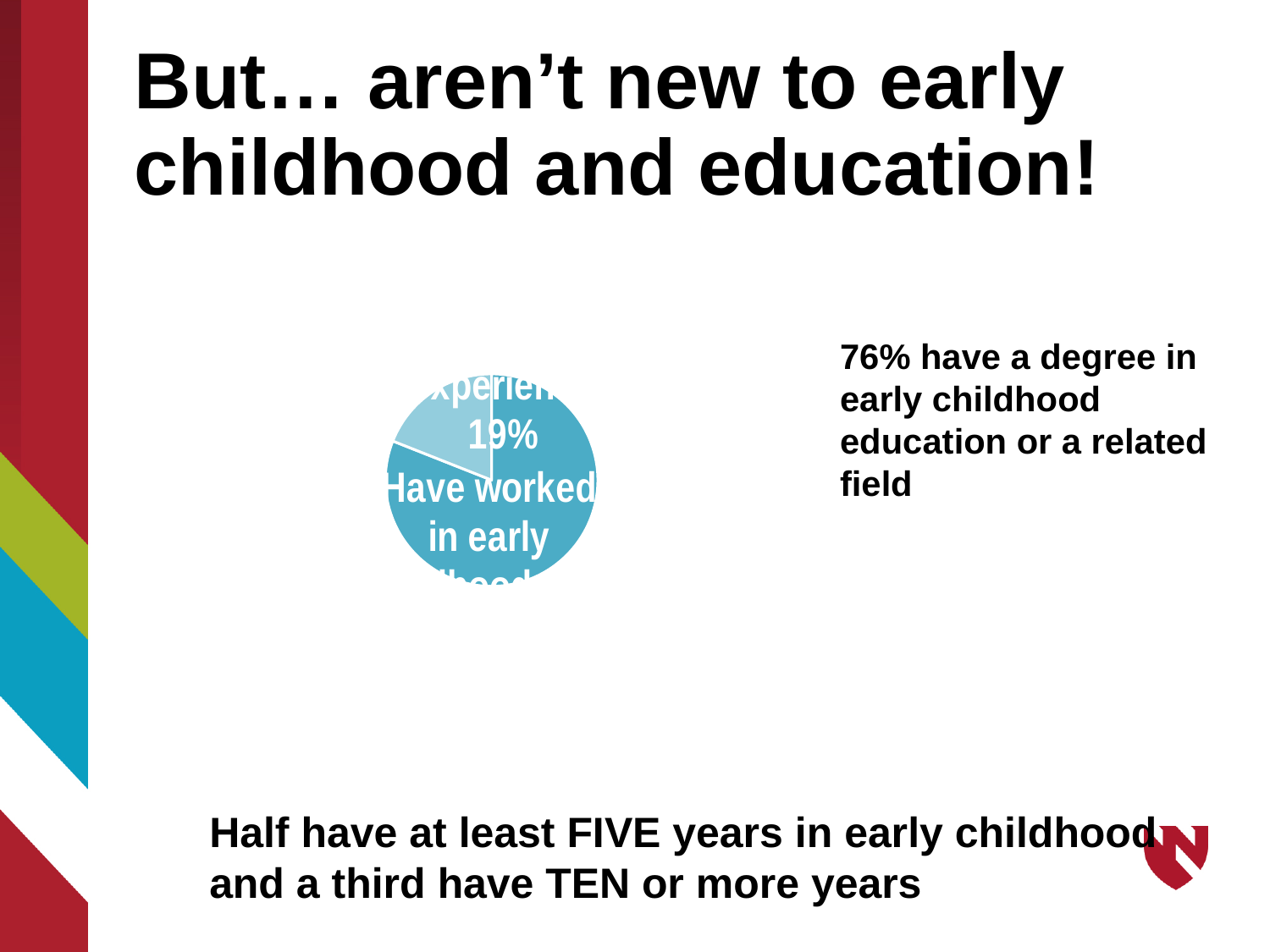
What percentage is printed on the smaller slice of the pie chart? 19% How many slices does the pie chart have? 2 Which slice of the pie chart is larger: the 19% slice or the 'Have worked in early childhood' slice? Have worked in early childhood What kind of chart is shown on the slide? pie chart Is the smaller slice of the pie chart greater or less than 25% of the pie? less What colour is the larger slice of the pie chart? teal blue Is the 'Have worked in early childhood' slice greater or less than 50% of the pie? greater